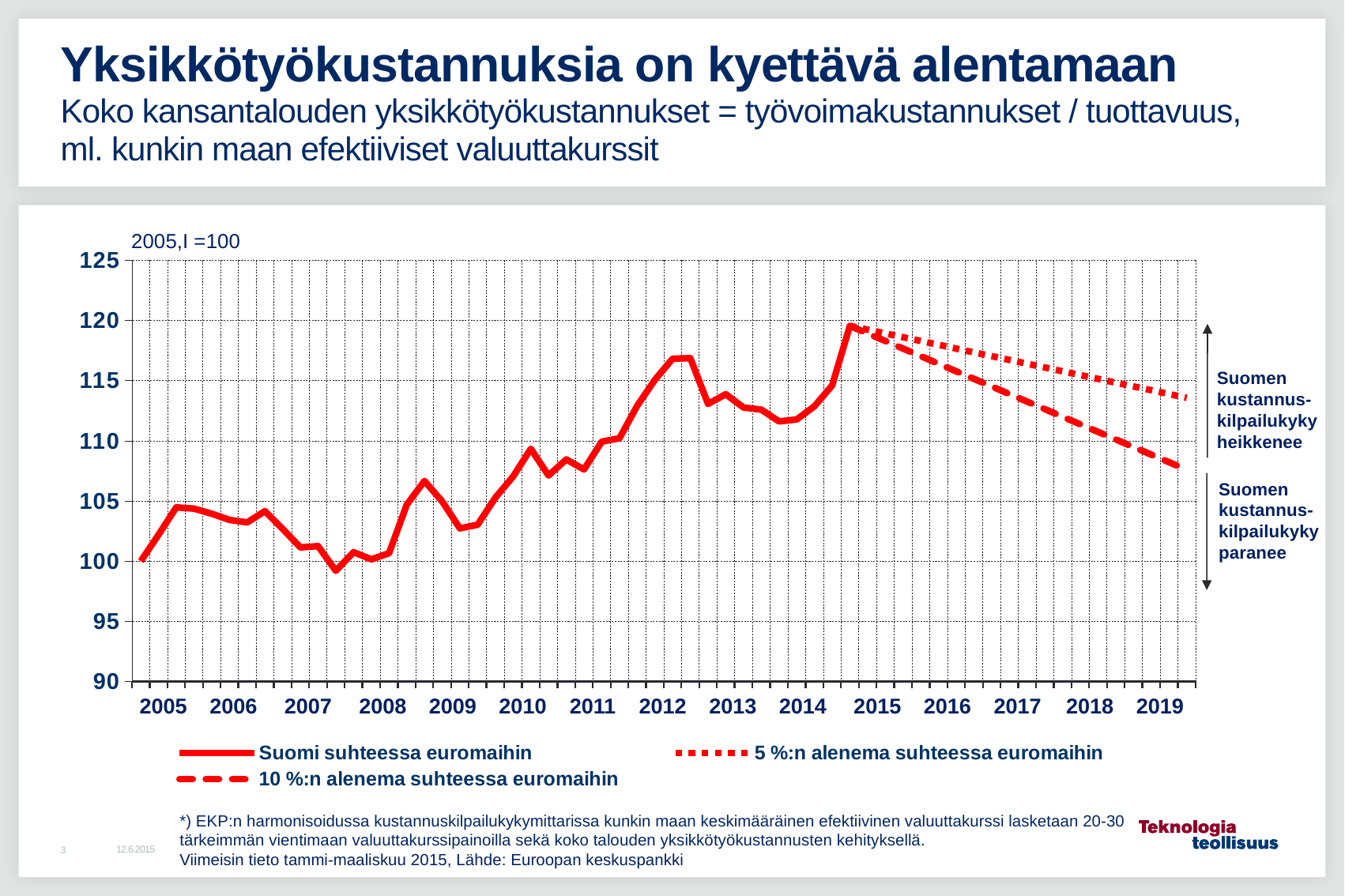
In which year does the 'Suomi suhteessa euromaihin' line reach its highest value? 2015 Is the peak of the 'Suomi suhteessa euromaihin' line in 2012 greater or less than 115? greater How many year labels are shown on the x axis? 15 Is the value of the '10 %:n alenema suhteessa euromaihin' line at the end of 2019 greater or less than 110? less How many series does the legend list? 3 What is the index value of the 'Suomi suhteessa euromaihin' series at the base point 2005,I? 100 Is the value of the 'Suomi suhteessa euromaihin' line at the start of 2015 greater or less than 115? greater Does the 'Suomi suhteessa euromaihin' line overall rise or fall from 2005 to 2015? rise Which series is drawn with a solid line according to the legend? Suomi suhteessa euromaihin What kind of chart is shown on the slide? line chart At the end of 2019, which line is higher: '5 %:n alenema suhteessa euromaihin' or '10 %:n alenema suhteessa euromaihin'? 5 %:n alenema suhteessa euromaihin